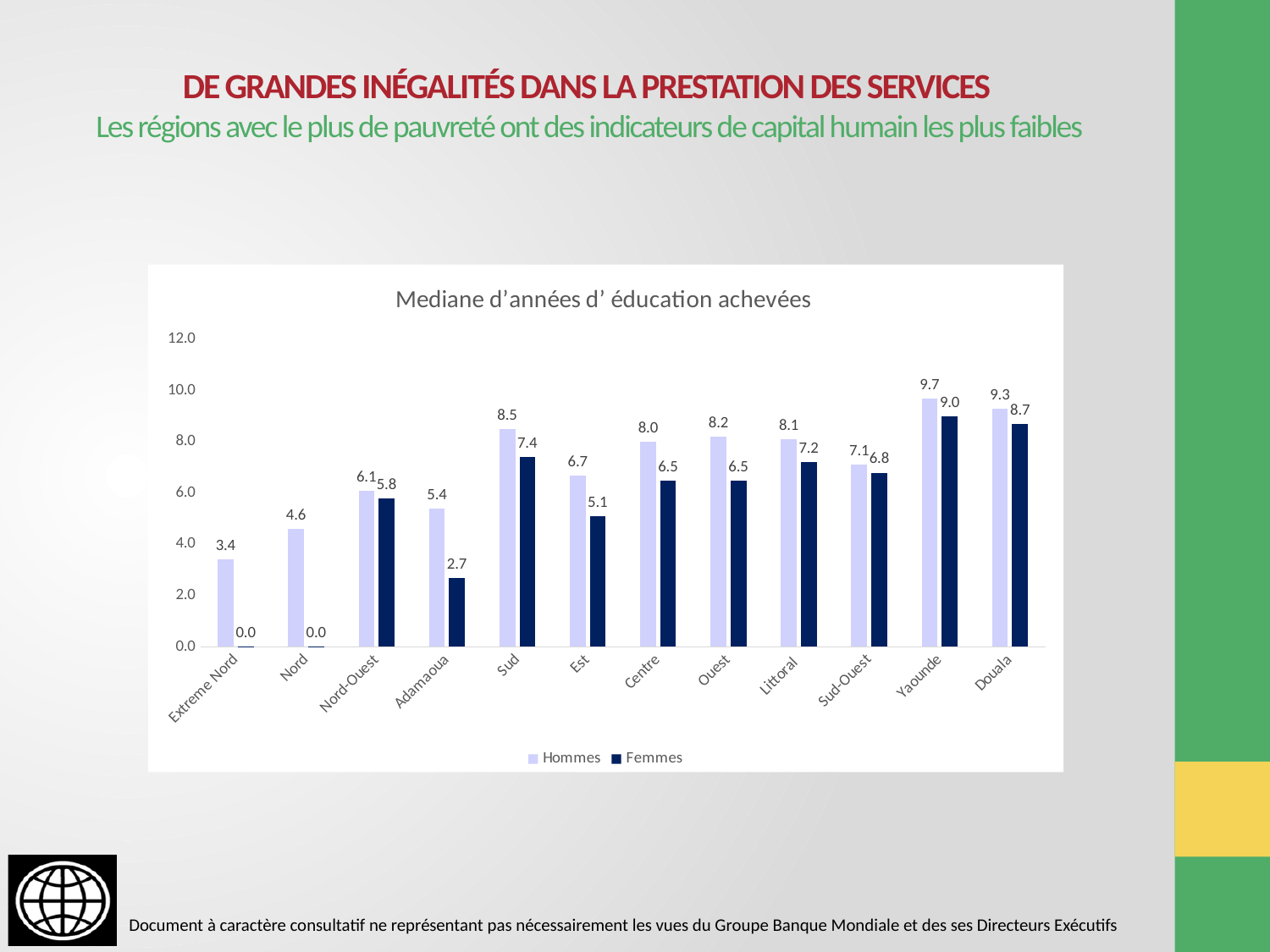
What is the Femmes value for Adamaoua? 2.7 How many series does the legend list? 2 What is the Hommes value for Sud? 8.5 Is the Hommes value for Est greater or less than 6.0? greater Which is larger, the Femmes value for Sud or the Femmes value for Sud-Ouest? Sud What is the title of the chart? Mediane d’années d’ éducation achevées What is the difference between the Hommes values for Douala and Nord? 4.7 Which region has the highest Hommes value? Yaounde How many regions are shown on the x axis? 12 What is the difference between the Hommes and Femmes values for Adamaoua? 2.7 What is the Femmes value for Littoral? 7.2 Which region has the lowest Hommes value? Extreme Nord